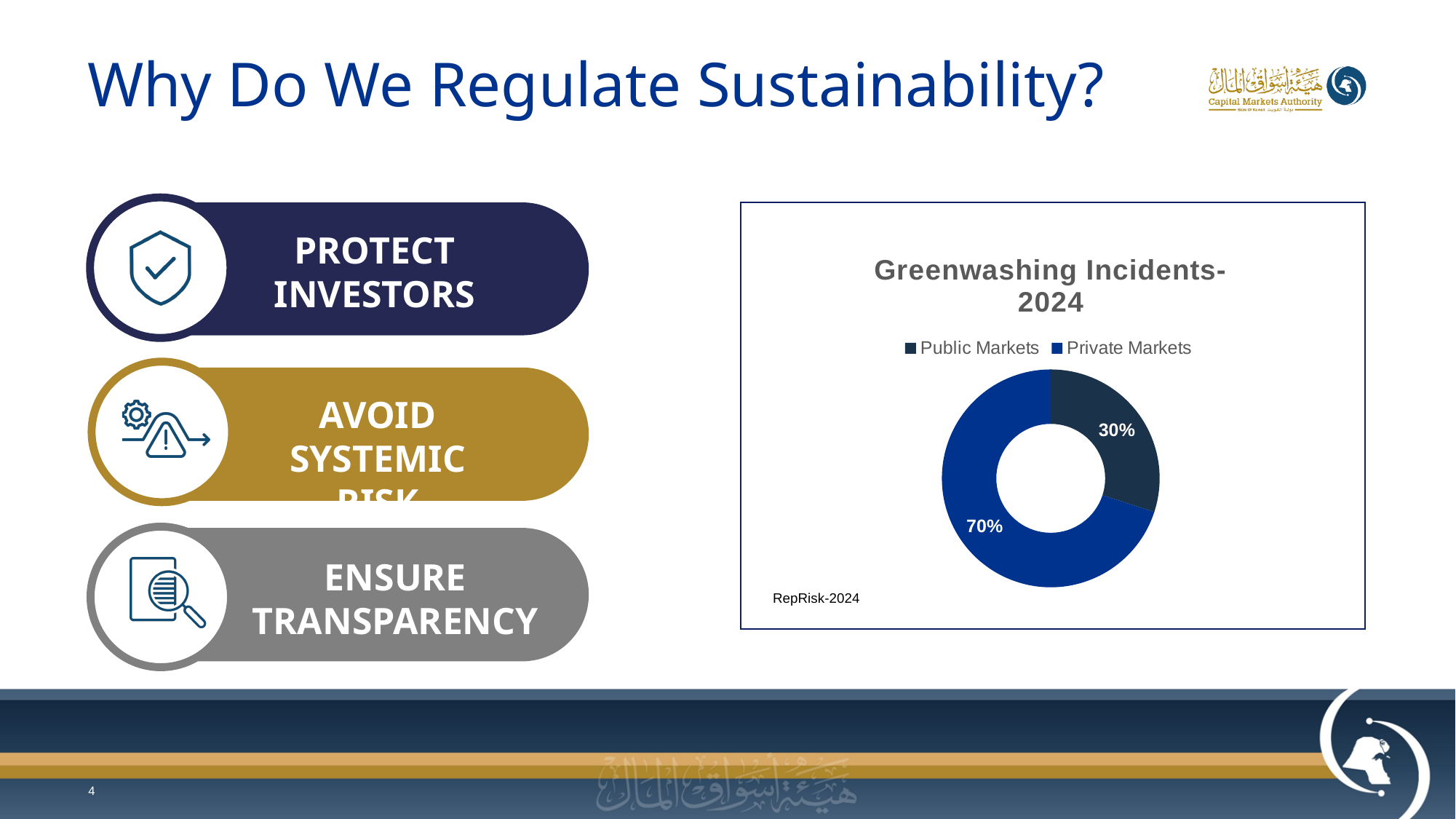
What is the title of the chart on the slide? Greenwashing Incidents-2024 Which category accounts for the largest share of greenwashing incidents in 2024? Private Markets How many categories are shown in the Greenwashing Incidents-2024 chart? 2 What kind of chart is used to show Greenwashing Incidents-2024? Pie chart (doughnut) What is the difference in percentage points between the Private Markets and Public Markets shares? 40 percentage points Which is larger: the share for Public Markets or the share for Private Markets? Private Markets Which category accounts for the smallest share of greenwashing incidents in 2024? Public Markets What source is cited below the chart? RepRisk-2024 What share of greenwashing incidents in 2024 is attributed to Public Markets? 30% What is the total of the two shares shown in the Greenwashing Incidents-2024 chart? 100% How many entries does the legend of the Greenwashing Incidents-2024 chart list? 2 What share of greenwashing incidents in 2024 is attributed to Private Markets? 70%